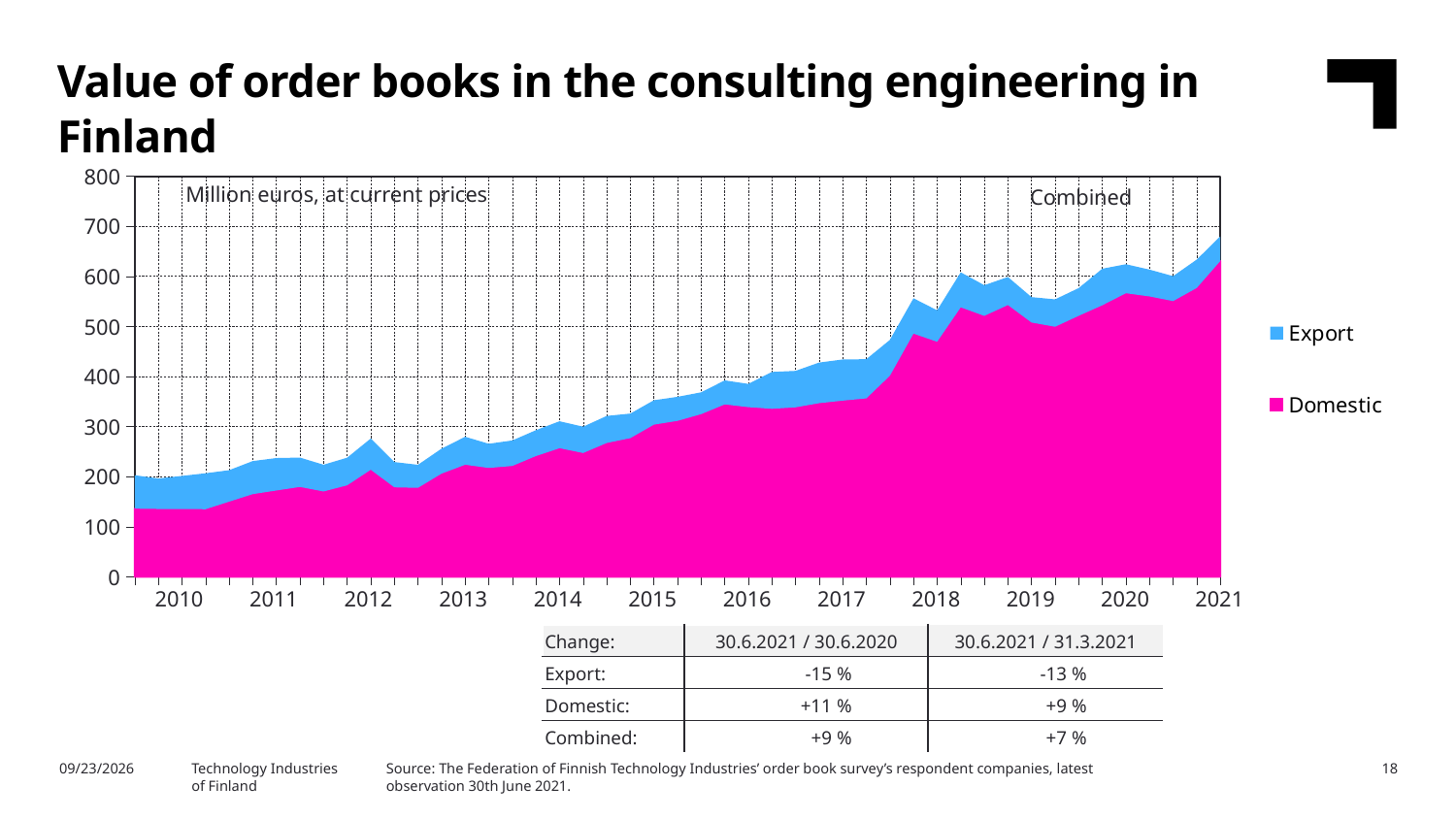
Is the combined value of order books in 2012 greater or less than 400? less How many series does the chart legend list? 2 Does the combined value of order books generally rise or fall from 2010 to 2021? Rise What unit is stated in the chart for the values? Million euros, at current prices Is the combined value of order books at the end of 2021 greater or less than 600? greater How many years are labelled on the x axis of the chart? 12 Is the Domestic value at the start of 2010 greater or less than 100? greater Which series is larger throughout the chart, Export or Domestic? Domestic Which two series are listed in the chart legend? Export and Domestic What kind of chart is shown on the slide? Stacked area chart